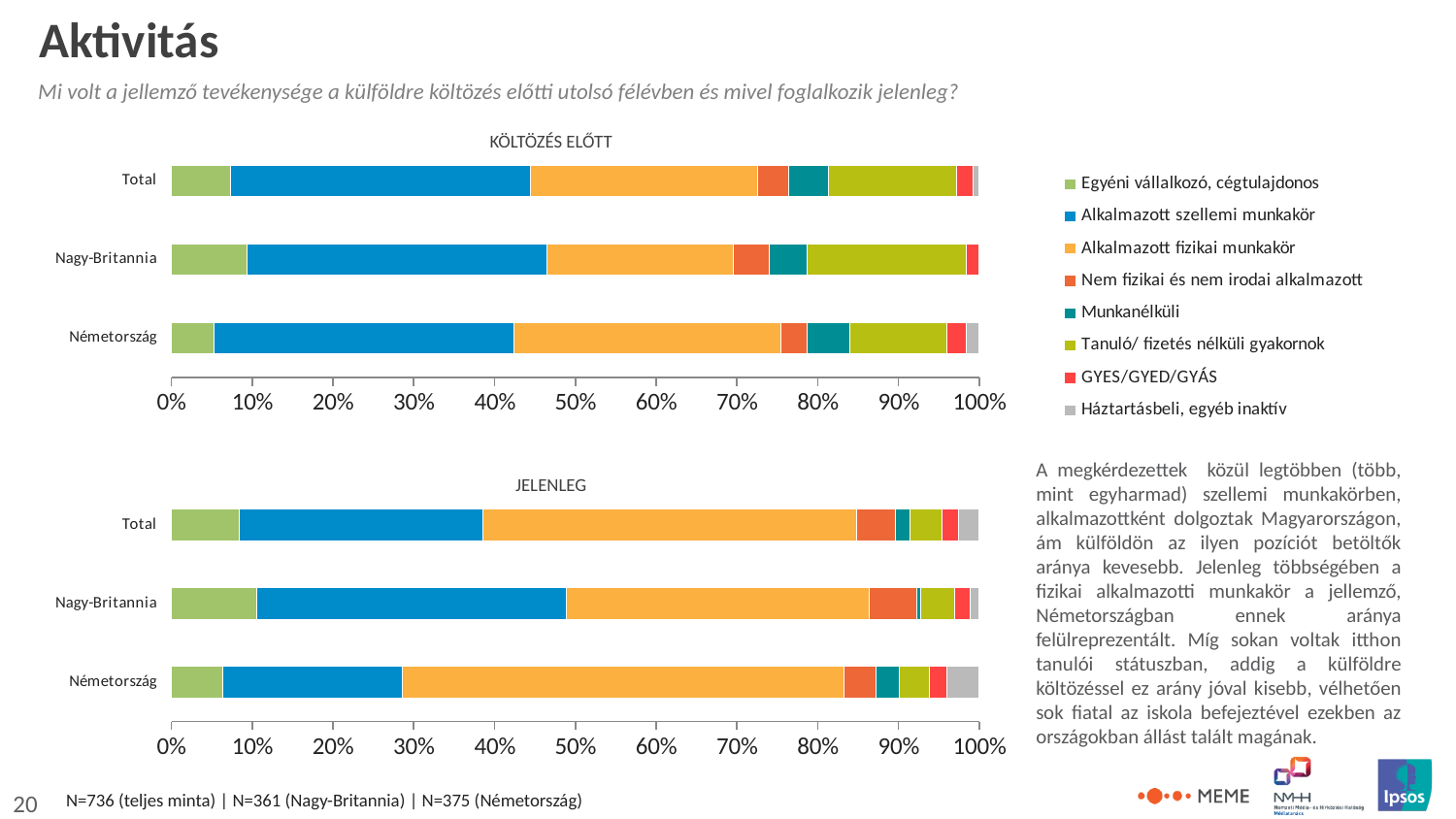
In the "JELENLEG" chart, is the share of Alkalmazott szellemi munkakör for Németország greater or less than 30%? less In the "JELENLEG" chart, is the share of Alkalmazott fizikai munkakör for Total greater or less than 40%? greater What kind of chart is the "KÖLTÖZÉS ELŐTT" chart? Stacked bar chart In the "JELENLEG" chart, which series has the largest share in the Total bar? Alkalmazott fizikai munkakör How many categories (bars) does the "JELENLEG" chart show? 3 In the "JELENLEG" chart, which has the larger Alkalmazott fizikai munkakör share: Nagy-Britannia or Németország? Németország In the "KÖLTÖZÉS ELŐTT" chart, is the share of Alkalmazott szellemi munkakör for Total greater or less than 30%? greater Which legend entry is shown in orange (the third entry)? Alkalmazott fizikai munkakör What is the title of the upper chart? KÖLTÖZÉS ELŐTT In the "JELENLEG" chart, which has the larger Alkalmazott szellemi munkakör share: Nagy-Britannia or Németország? Nagy-Britannia In the "KÖLTÖZÉS ELŐTT" chart, which has the larger Egyéni vállalkozó, cégtulajdonos share: Nagy-Britannia or Németország? Nagy-Britannia How many series does the legend list for the charts? 8